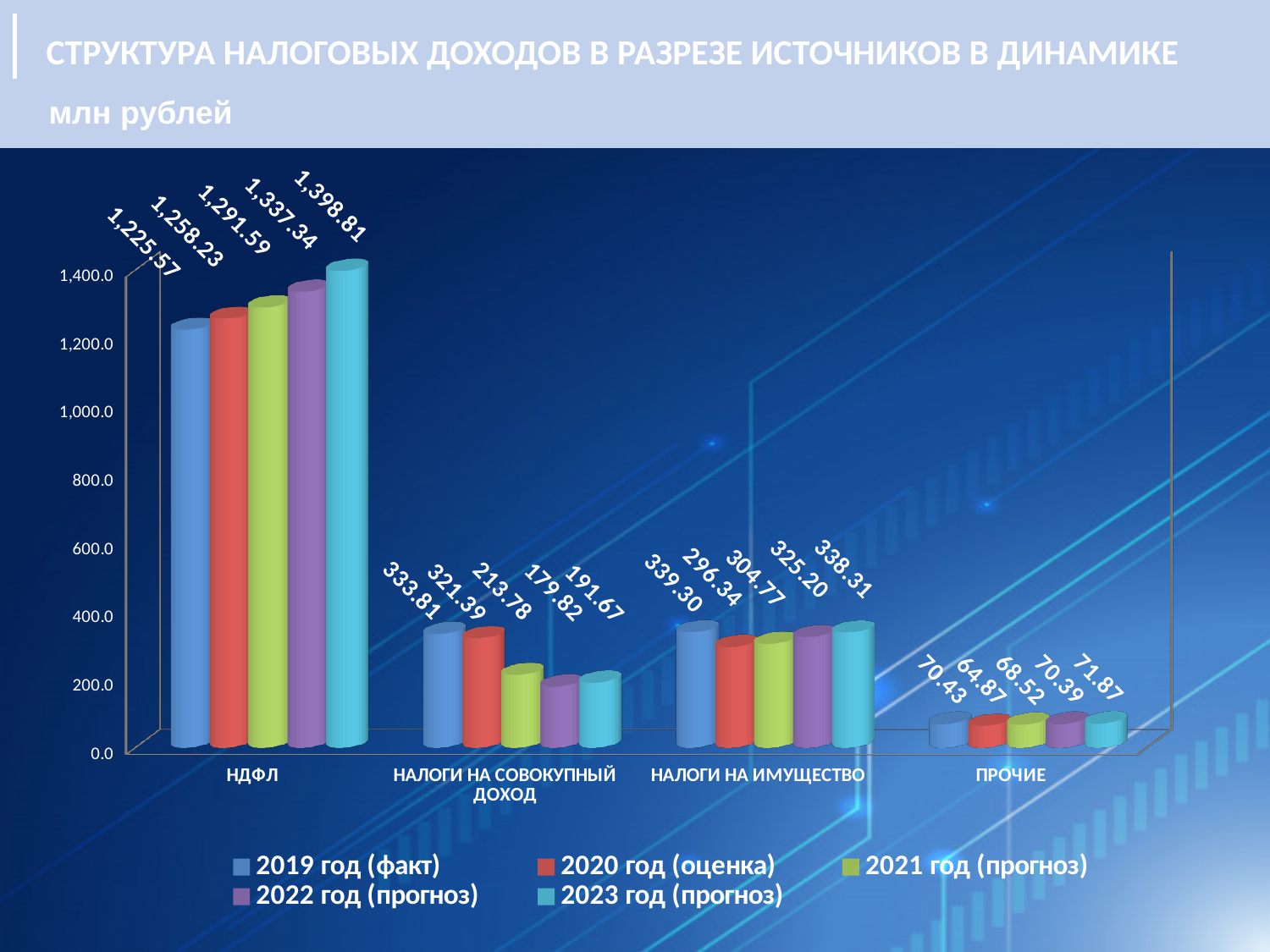
How many categories are shown on the x axis? 4 Which category has the lowest value in the 2019 год (факт) series? ПРОЧИЕ What is the value for НАЛОГИ НА ИМУЩЕСТВО in the 2020 год (оценка) series? 296.34 Do the values for НДФЛ rise or fall from 2019 год (факт) to 2023 год (прогноз)? rise What is the value for ПРОЧИЕ in the 2023 год (прогноз) series? 71.87 How many series does the legend list? 5 What is the difference between the 2023 год (прогноз) and 2019 год (факт) values for НДФЛ? 173.24 What is the value for НДФЛ in the 2019 год (факт) series? 1,225.57 What is the value for НАЛОГИ НА СОВОКУПНЫЙ ДОХОД in the 2022 год (прогноз) series? 179.82 What kind of chart is shown on the slide? bar chart Which category has the highest value in the 2023 год (прогноз) series? НДФЛ Which is larger for НАЛОГИ НА СОВОКУПНЫЙ ДОХОД: the 2021 год (прогноз) value or the 2023 год (прогноз) value? 2021 год (прогноз)